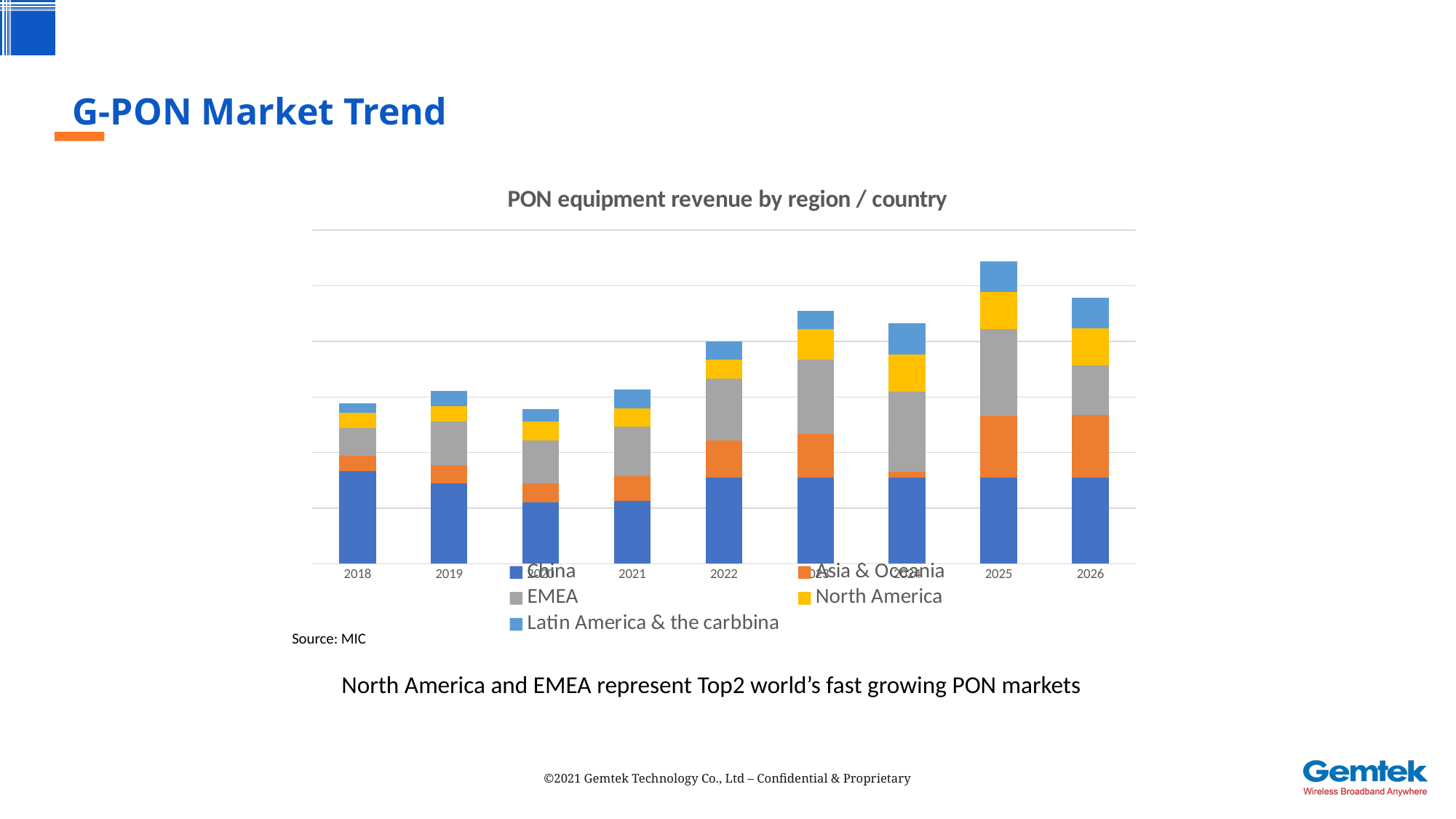
Which year has the taller total bar, 2019 or 2022? 2022 In which year is the EMEA segment the largest? 2025 What is the title of the chart? PON equipment revenue by region / country Which year has the taller total bar, 2023 or 2024? 2023 Does the total PON equipment revenue generally rise or fall from 2018 to 2026? Rise What type of chart is shown on the slide? Stacked bar chart Which year has the tallest stacked bar in the chart? 2025 How many years are shown on the x axis of the chart? 9 Which year has the taller total bar, 2025 or 2026? 2025 Which series is shown at the bottom of each stacked bar? China How many series does the chart legend list? 5